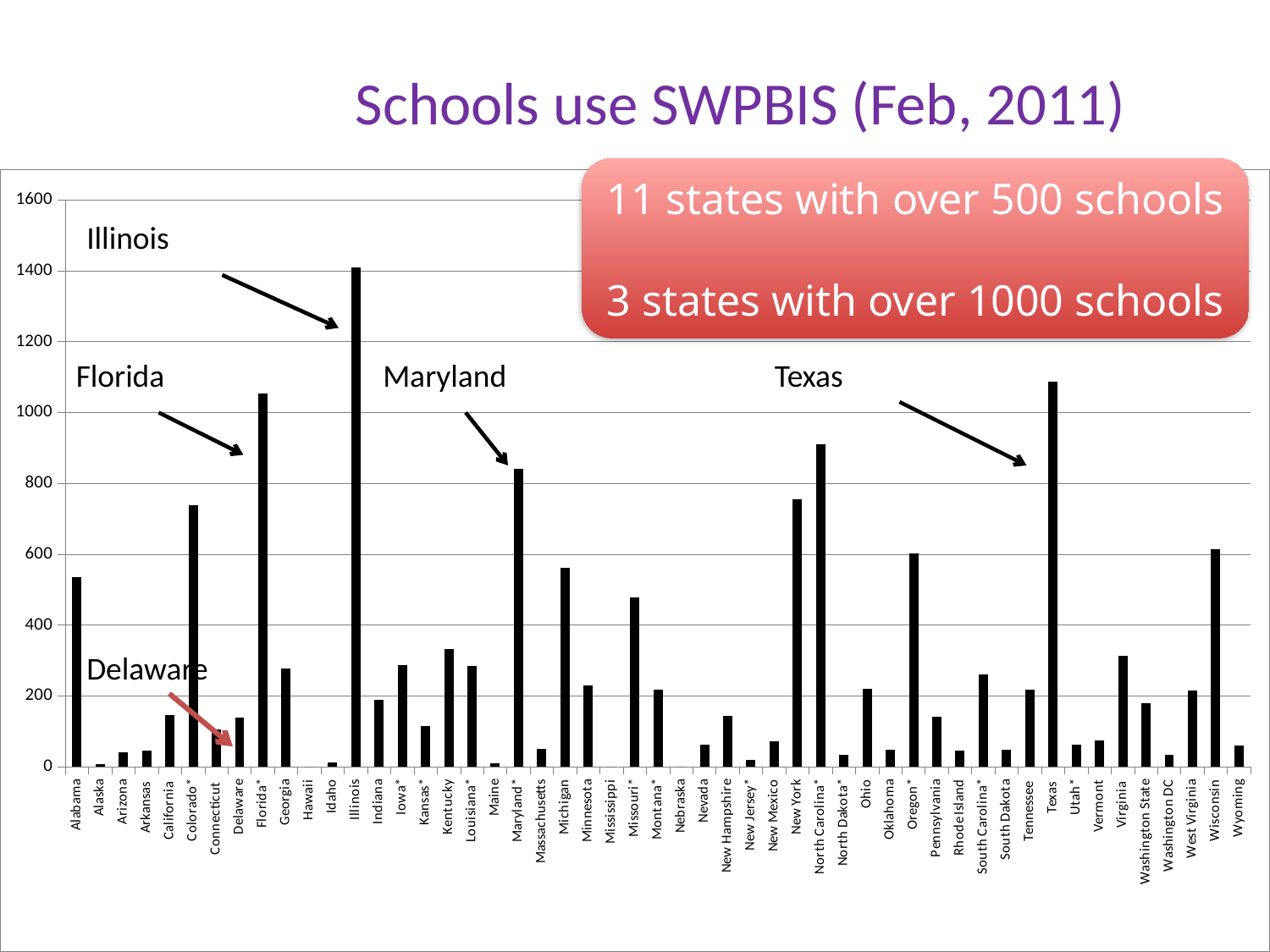
Is the value for Delaware greater or less than 200? less Which state has the highest number of schools using SWPBIS? Illinois What kind of chart is shown on the slide? bar chart Is the value for Michigan greater or less than 400? greater Is the value for Maryland* greater or less than 1000? less Which has a higher value, Illinois or Texas? Illinois According to the callout on the slide, how many states have over 1000 schools? 3 states Which has a higher value, Florida* or Maryland*? Florida* What is the title of the chart? Schools use SWPBIS (Feb, 2011)